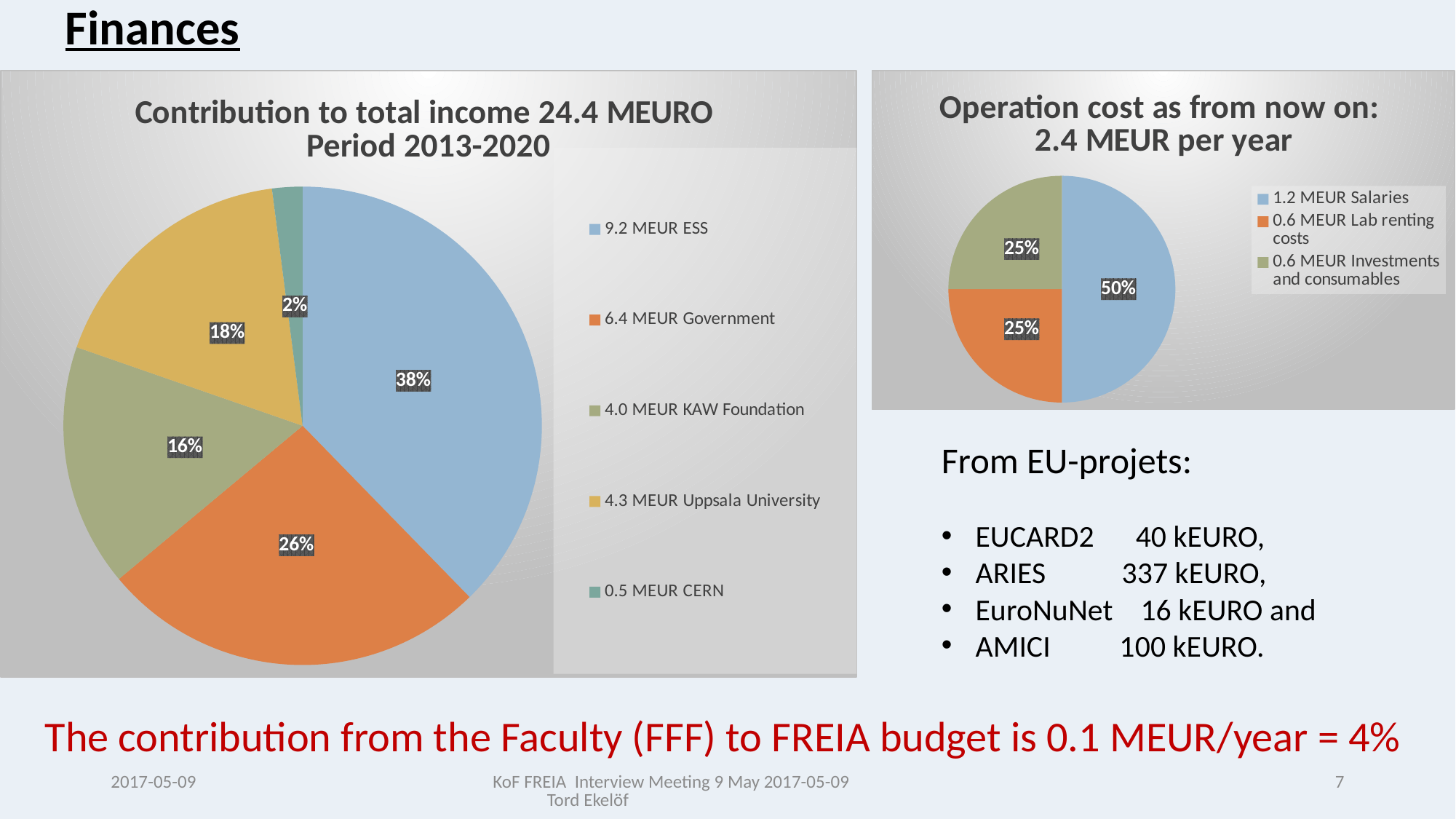
In the 'Contribution to total income 24.4 MEURO Period 2013-2020' chart, which contributor has the smallest slice? 0.5 MEUR CERN What type of chart is the 'Operation cost as from now on: 2.4 MEUR per year' chart? Pie chart In the 'Contribution to total income 24.4 MEURO Period 2013-2020' chart, what share of the pie does ESS account for? 38% In the 'Contribution to total income 24.4 MEURO Period 2013-2020' chart, what colour is the ESS slice? Blue In the 'Operation cost as from now on: 2.4 MEUR per year' chart, how many categories does the legend list? 3 In the 'Operation cost as from now on: 2.4 MEUR per year' chart, what share of the pie is Salaries? 50% In the 'Contribution to total income 24.4 MEURO Period 2013-2020' chart, what percentage is shown for the Government slice? 26% In the 'Operation cost as from now on: 2.4 MEUR per year' chart, which category has the largest slice? 1.2 MEUR Salaries In the 'Contribution to total income 24.4 MEURO Period 2013-2020' chart, what is the difference in percentage points between the Uppsala University slice and the KAW Foundation slice? 2% In the 'Contribution to total income 24.4 MEURO Period 2013-2020' chart, how many slices does the pie have? 5 In the 'Contribution to total income 24.4 MEURO Period 2013-2020' chart, which contributor has the largest slice? 9.2 MEUR ESS In the 'Contribution to total income 24.4 MEURO Period 2013-2020' chart, which is larger, the Government slice or the Uppsala University slice? Government